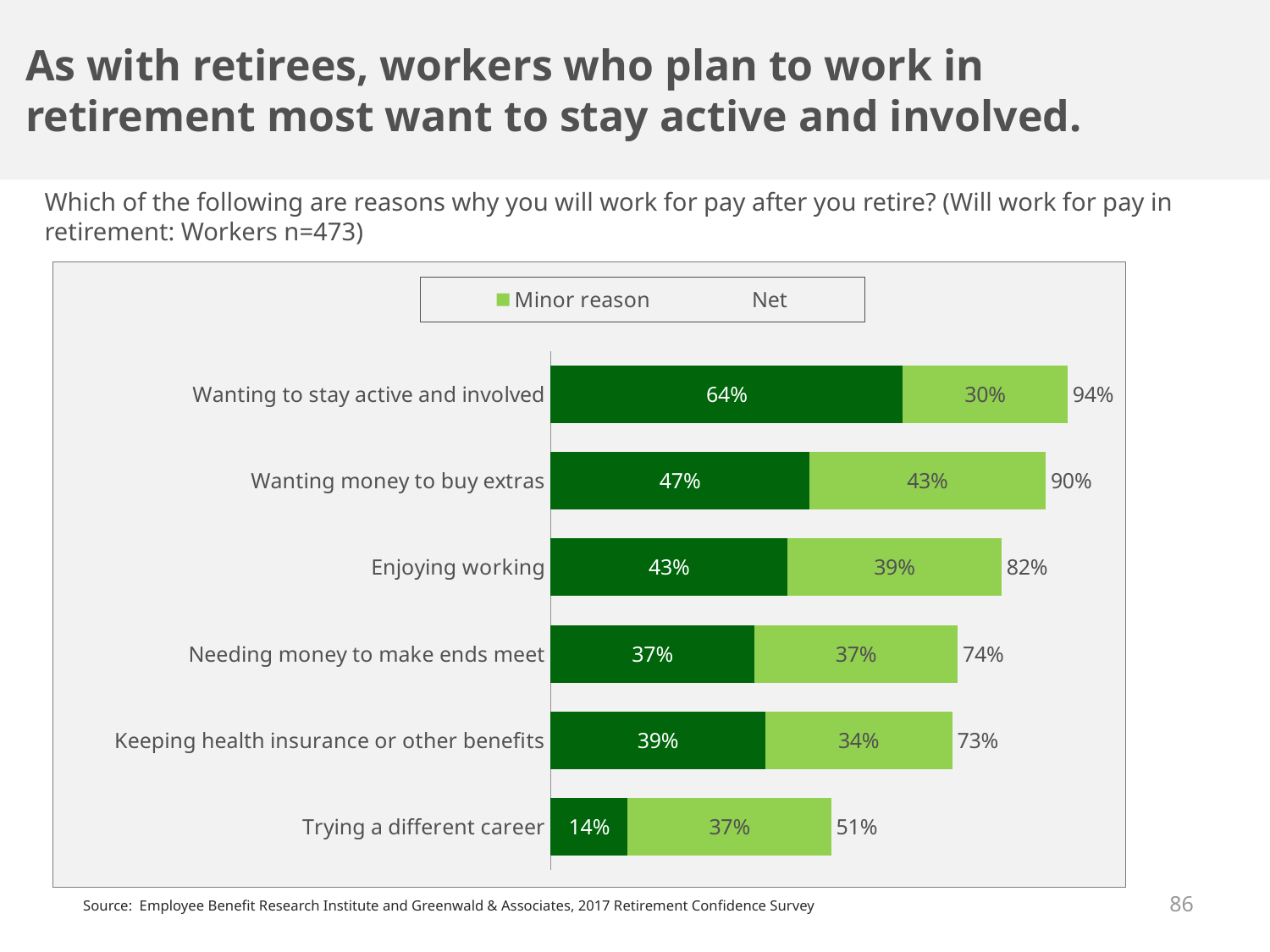
What is the Net value for Wanting to stay active and involved? 94% Which category has the lowest Net value? Trying a different career What is the difference between the Net values for Wanting money to buy extras and Enjoying working? 8% What is the Minor reason value for Keeping health insurance or other benefits? 34% What is the Net value for Trying a different career? 51% What kind of chart is shown on the slide? Bar chart Which is larger, the Minor reason value for Enjoying working or for Needing money to make ends meet? Enjoying working Which category has the lowest Minor reason value? Wanting to stay active and involved Which category has the highest Net value? Wanting to stay active and involved How many categories are shown in the chart? 6 What is the Minor reason value for Wanting money to buy extras? 43% What is the sample size stated in the chart's question text? n=473